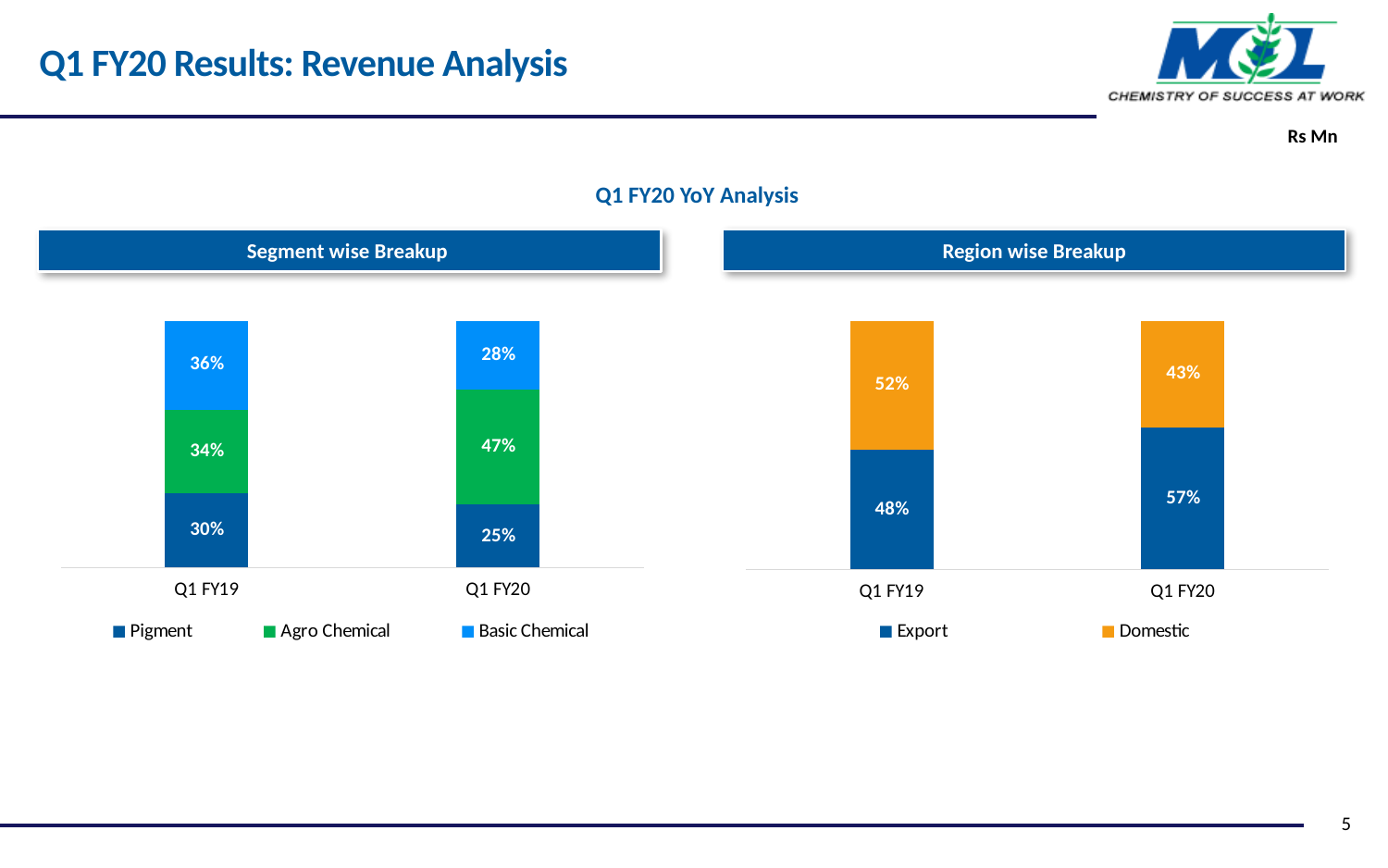
What kind of chart is the Region wise Breakup chart? Stacked bar chart In the Region wise Breakup chart, which is larger in Q1 FY19, Export or Domestic? Domestic In the Region wise Breakup chart, does the Export share rise or fall from Q1 FY19 to Q1 FY20? Rise In the Segment wise Breakup chart, what is the difference between Basic Chemical in Q1 FY19 and Q1 FY20? 8% In the Segment wise Breakup chart, which segment has the lowest share in Q1 FY19? Pigment In the Region wise Breakup chart, what is the value for Export in Q1 FY20? 57% In the Segment wise Breakup chart, which segment has the highest share in Q1 FY20? Agro Chemical In the Region wise Breakup chart, what is the value for Domestic in Q1 FY19? 52% In the Segment wise Breakup chart, what is the value for Pigment in Q1 FY19? 30% In the Region wise Breakup chart, what is the difference between Export and Domestic in Q1 FY20? 14% In the Segment wise Breakup chart, what is the value for Agro Chemical in Q1 FY20? 47% How many series does the legend of the Segment wise Breakup chart list? 3